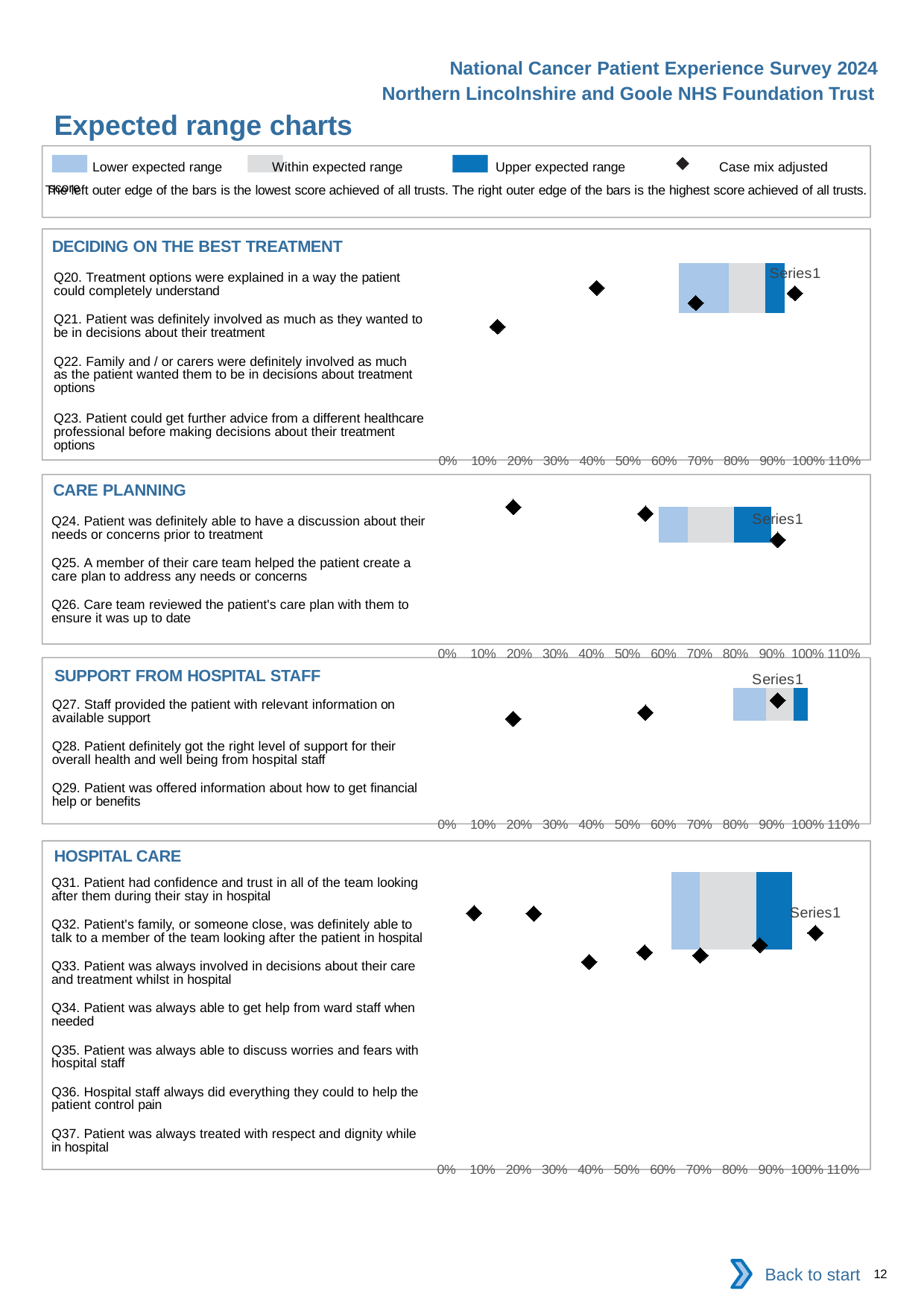
How many questions (categories) are listed in the 'DECIDING ON THE BEST TREATMENT' chart? 4 How many questions (categories) are listed in the 'CARE PLANNING' chart? 3 What is the highest tick label shown on the x axis of the 'HOSPITAL CARE' chart? 110% How many entries does the legend at the top of the slide list? 4 Which of the four charts on the slide lists the most questions? HOSPITAL CARE What kind of chart is used in the 'DECIDING ON THE BEST TREATMENT' section? bar chart What is the lowest tick label shown on the x axis of the 'CARE PLANNING' chart? 0% Which legend entry is represented by a diamond marker? Case mix adjusted score